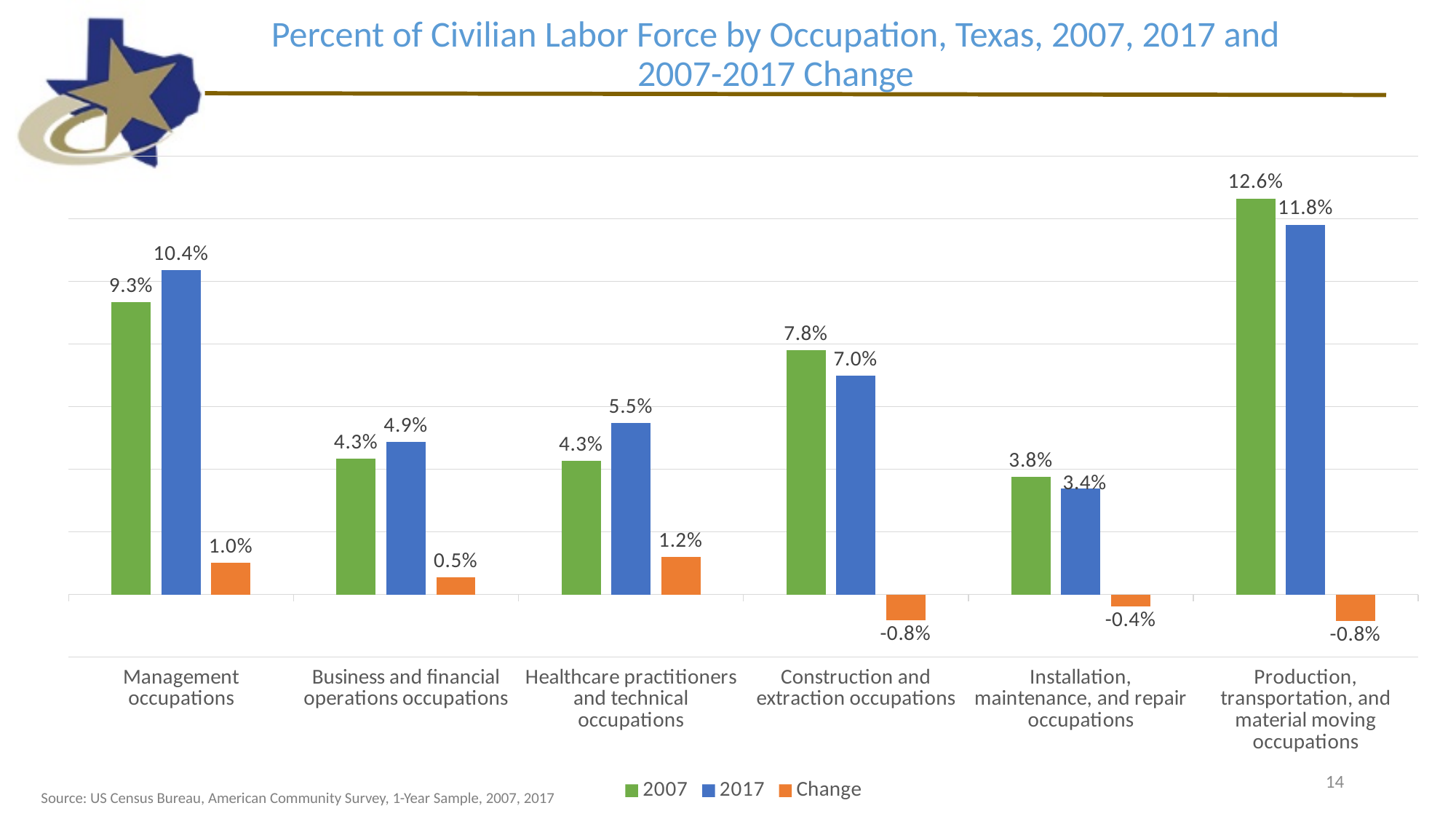
How many series does the legend list? 3 What is the Change value for Installation, maintenance, and repair occupations? -0.4% Which is larger for Business and financial operations occupations, the 2007 value or the 2017 value? 2017 What was the 2017 value for Management occupations? 10.4% What kind of chart is shown on the slide? Bar chart What is the difference between the 2007 and 2017 values for Production, transportation, and material moving occupations? 0.8% How many occupation categories are shown on the chart? 6 Which occupation category has the lowest 2007 value? Installation, maintenance, and repair occupations What is the Change value for Healthcare practitioners and technical occupations? 1.2% What colour represents the Change series in the chart? Orange Which occupation category has the highest 2017 value? Production, transportation, and material moving occupations What was the 2007 value for Construction and extraction occupations? 7.8%